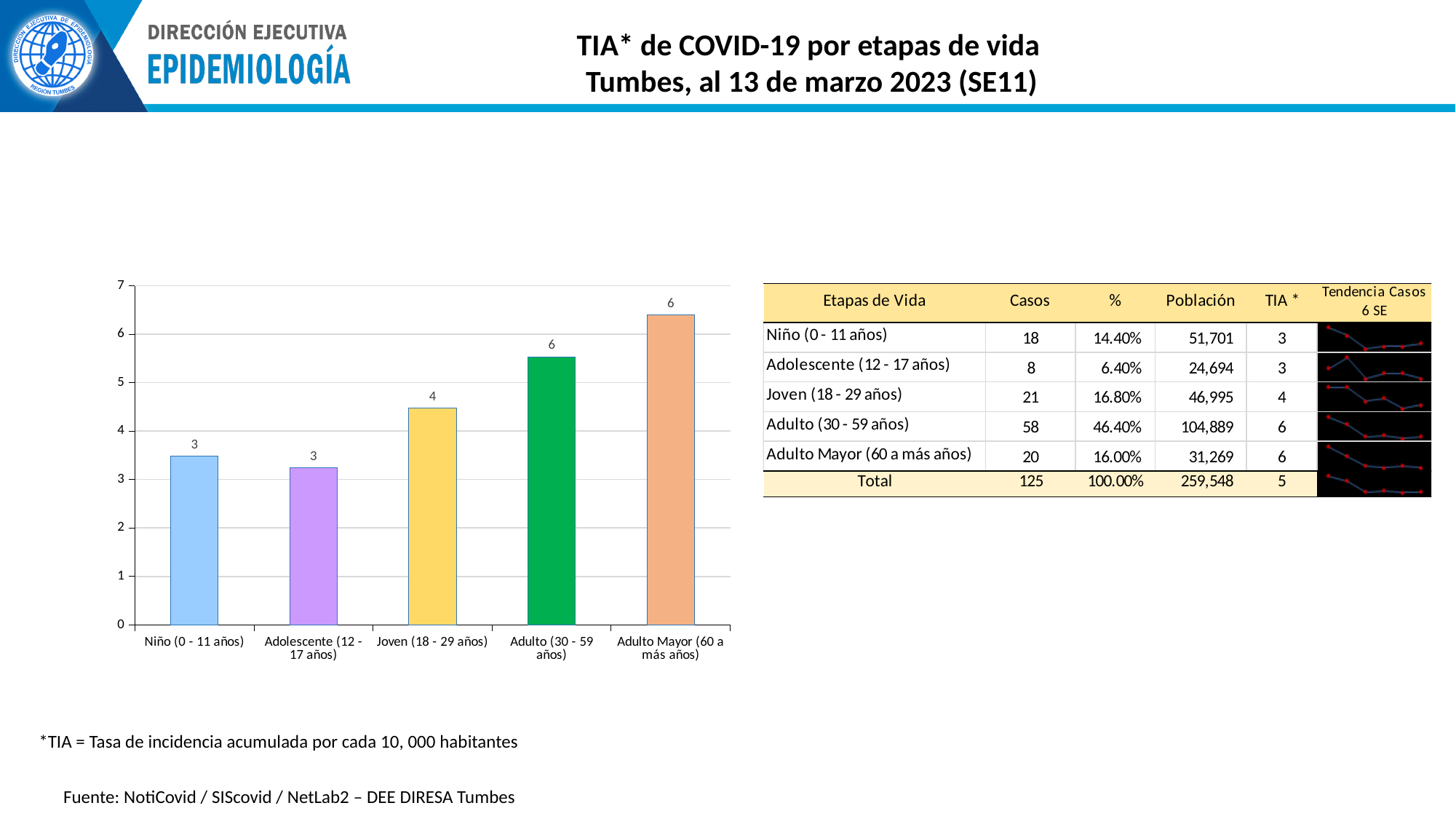
Which life stage has the highest bar in the chart? Adulto Mayor (60 a más años) What is the data label shown for Niño (0 - 11 años) in the bar chart? 3 Using the printed data labels, what is the difference between the value for Adulto Mayor (60 a más años) and the value for Niño (0 - 11 años)? 3 Which bar is taller in the chart: Joven (18 - 29 años) or Adolescente (12 - 17 años)? Joven (18 - 29 años) Is the bar for Adulto (30 - 59 años) greater or less than 5 on the axis? greater Do the bar values generally rise or fall from Niño to Adulto Mayor along the x axis? rise What is the data label shown for Adulto (30 - 59 años) in the bar chart? 6 How many life-stage categories are plotted in the bar chart? 5 What is the data label shown for Joven (18 - 29 años) in the bar chart? 4 Is the bar for Adolescente (12 - 17 años) greater or less than 4 on the axis? less Which bar is taller in the chart: Adulto (30 - 59 años) or Adulto Mayor (60 a más años)? Adulto Mayor (60 a más años) What kind of chart is shown on the slide? bar chart